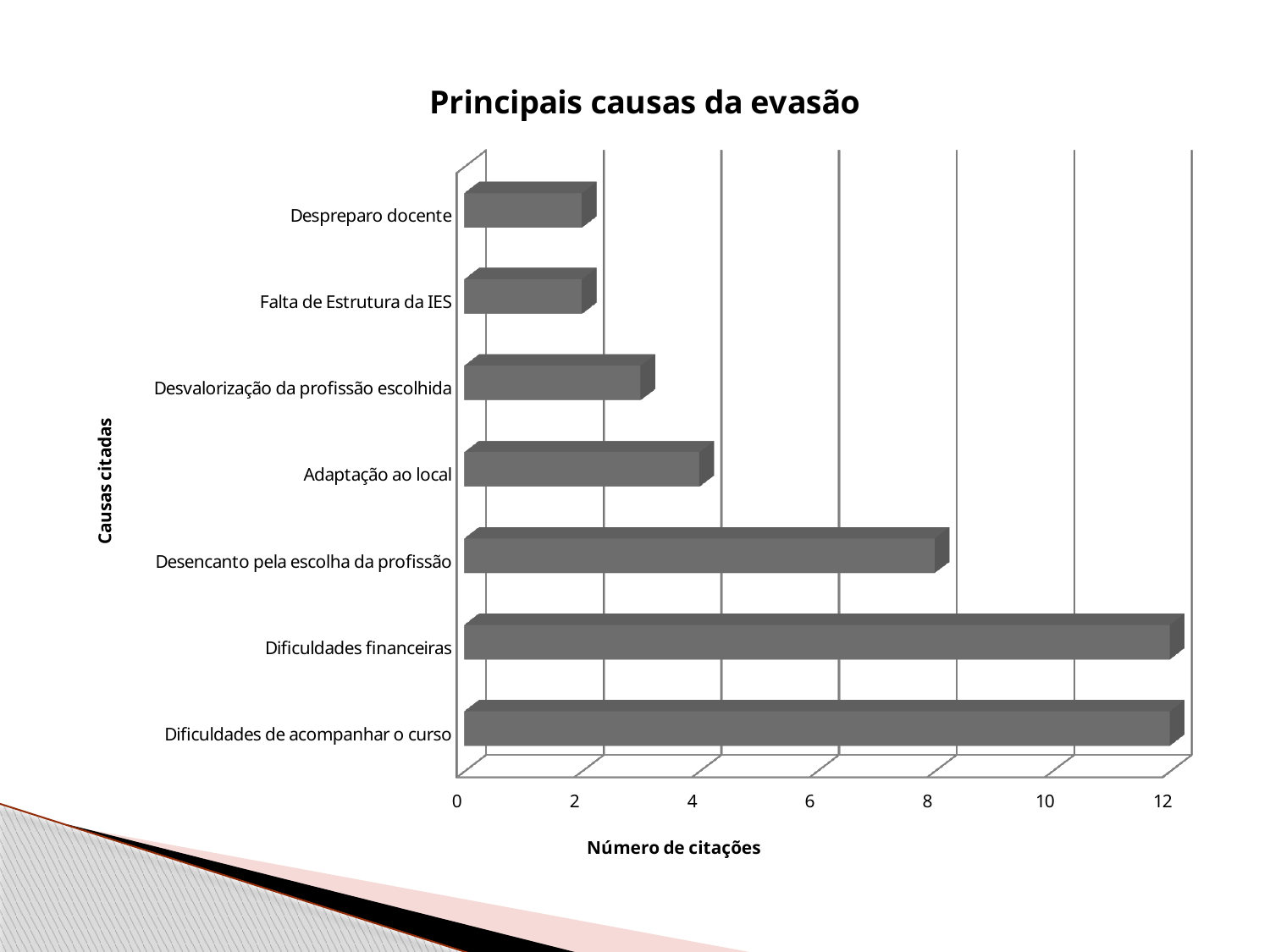
What is the label of the horizontal axis? Número de citações Which has more citations, Adaptação ao local or Falta de Estrutura da IES? Adaptação ao local What is the number of citations for Dificuldades financeiras? 12 Which has more citations, Dificuldades financeiras or Desencanto pela escolha da profissão? Dificuldades financeiras Is the value for Adaptação ao local greater or less than 6? less How many causes (categories) are plotted in the chart? 7 What is the number of citations for Desencanto pela escolha da profissão? 8 What is the title of the chart? Principais causas da evasão Is the value for Desvalorização da profissão escolhida greater or less than 2? greater Is the value for Despreparo docente greater or less than 4? less What kind of chart is shown on the slide? bar chart